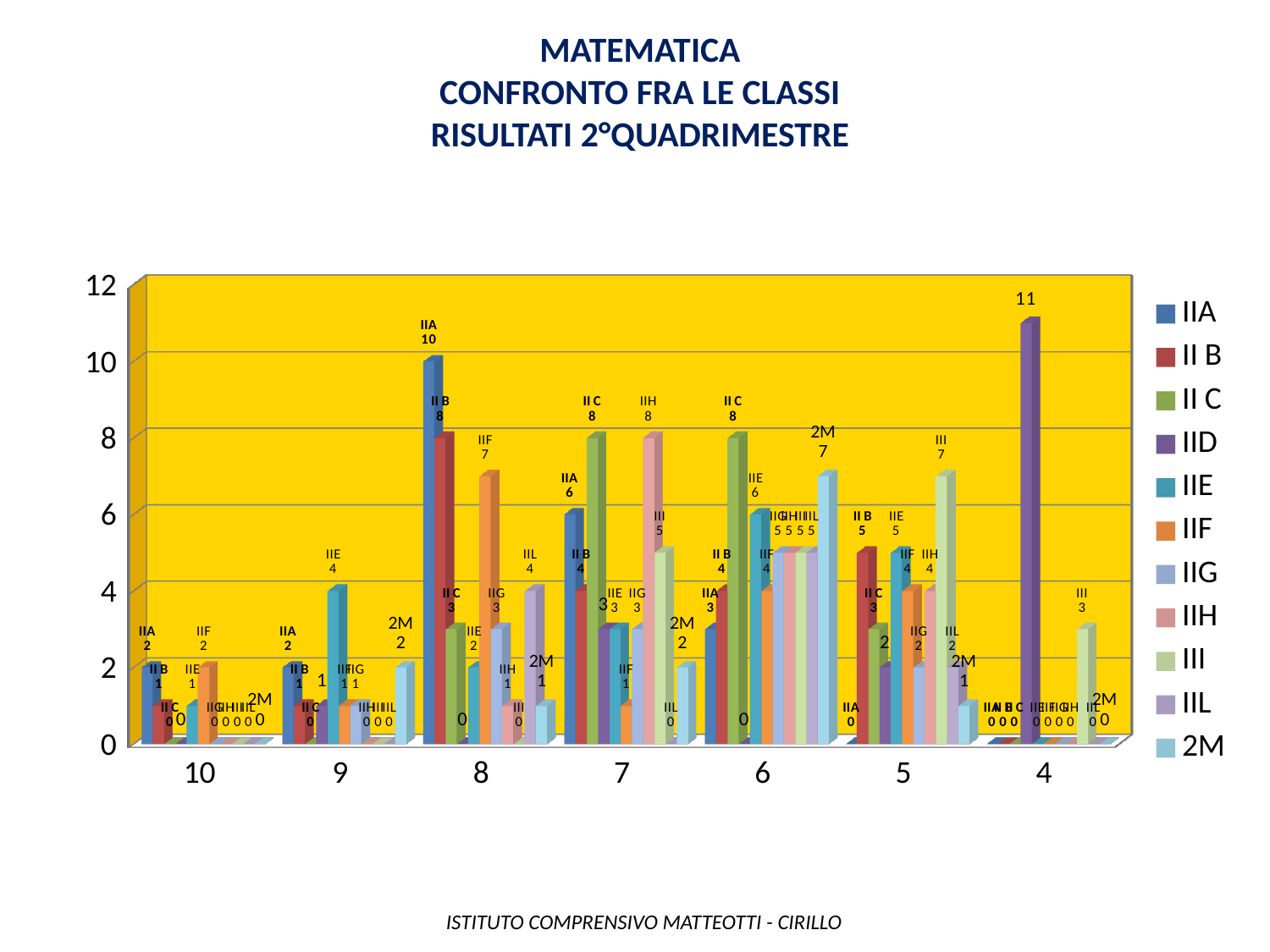
What is the value for IIA at category 8? 10 What is the difference between the IIA and II B values at category 8? 2 How many series does the legend list? 11 How many categories are shown on the x axis? 7 Which series has the highest bar in the whole chart, and at which category? IID at 4 At category 9, which is larger: IIE or IIF? IIE What is the value for 2M at category 6? 7 What is the value for III at category 5? 7 What is the value for IIH at category 7? 8 What kind of chart is shown on the slide? bar chart What is the first line of the chart title? MATEMATICA What is the value for IID at category 4? 11